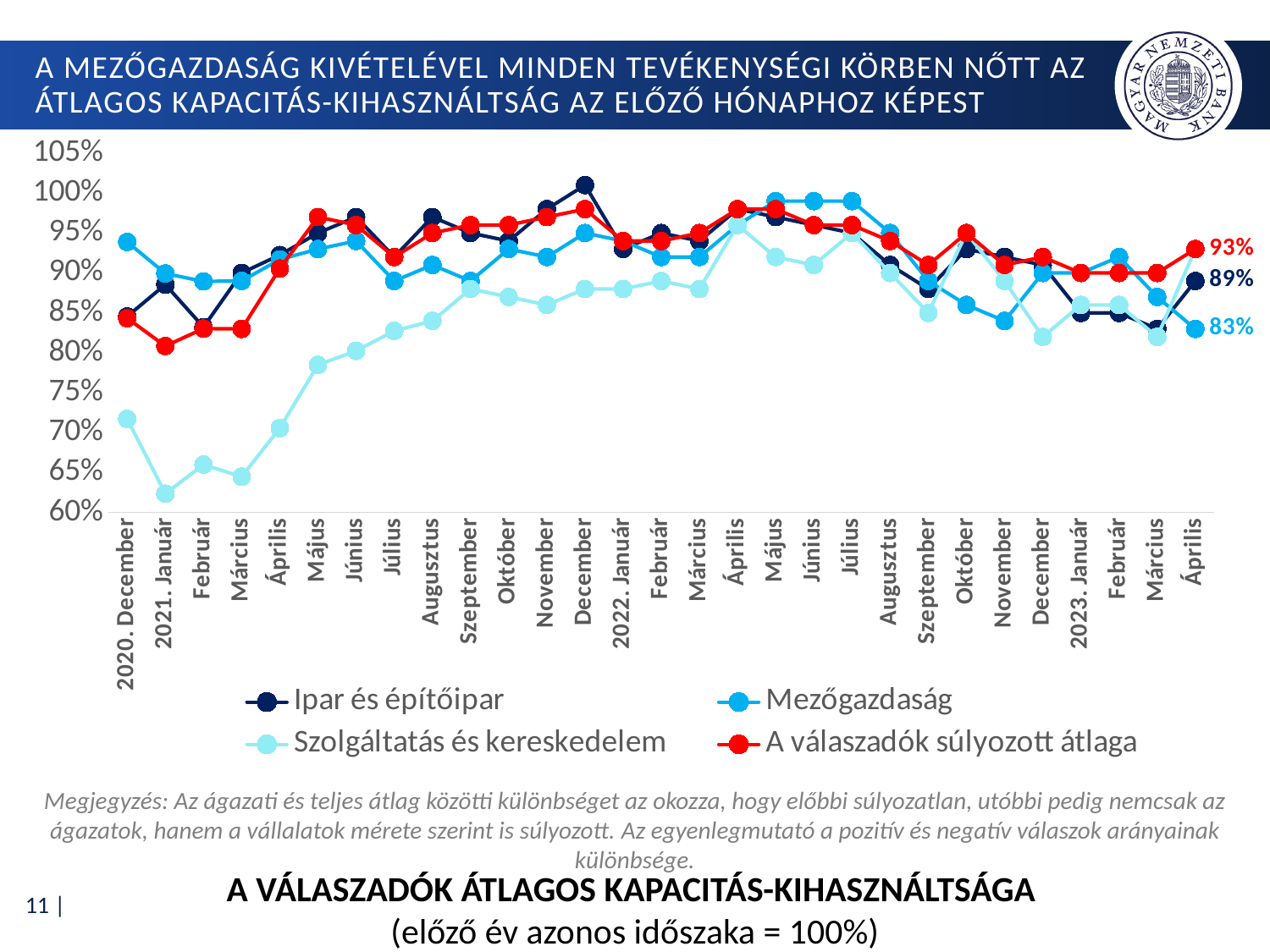
Does 'Szolgáltatás és kereskedelem' rise or fall from 2021. Január to Május 2021? rise What is the value of 'Ipar és építőipar' in Április 2023? 89% What kind of chart is shown on the slide? line chart Which series has the lowest value in 2021. Január? Szolgáltatás és kereskedelem In which month does 'Ipar és építőipar' reach its highest value? 2021 December How many months are shown on the x axis? 29 What is the difference between 'A válaszadók súlyozott átlaga' and 'Mezőgazdaság' in Április 2023? 10 percentage points What is the value of 'A válaszadók súlyozott átlaga' in Április 2023? 93% In Április 2023, which is larger: 'Ipar és építőipar' or 'Mezőgazdaság'? Ipar és építőipar What is the value of 'Mezőgazdaság' in Április 2023? 83% How many series does the legend list? 4 Is the value for 'Szolgáltatás és kereskedelem' in 2021. Január greater or less than 65%? less